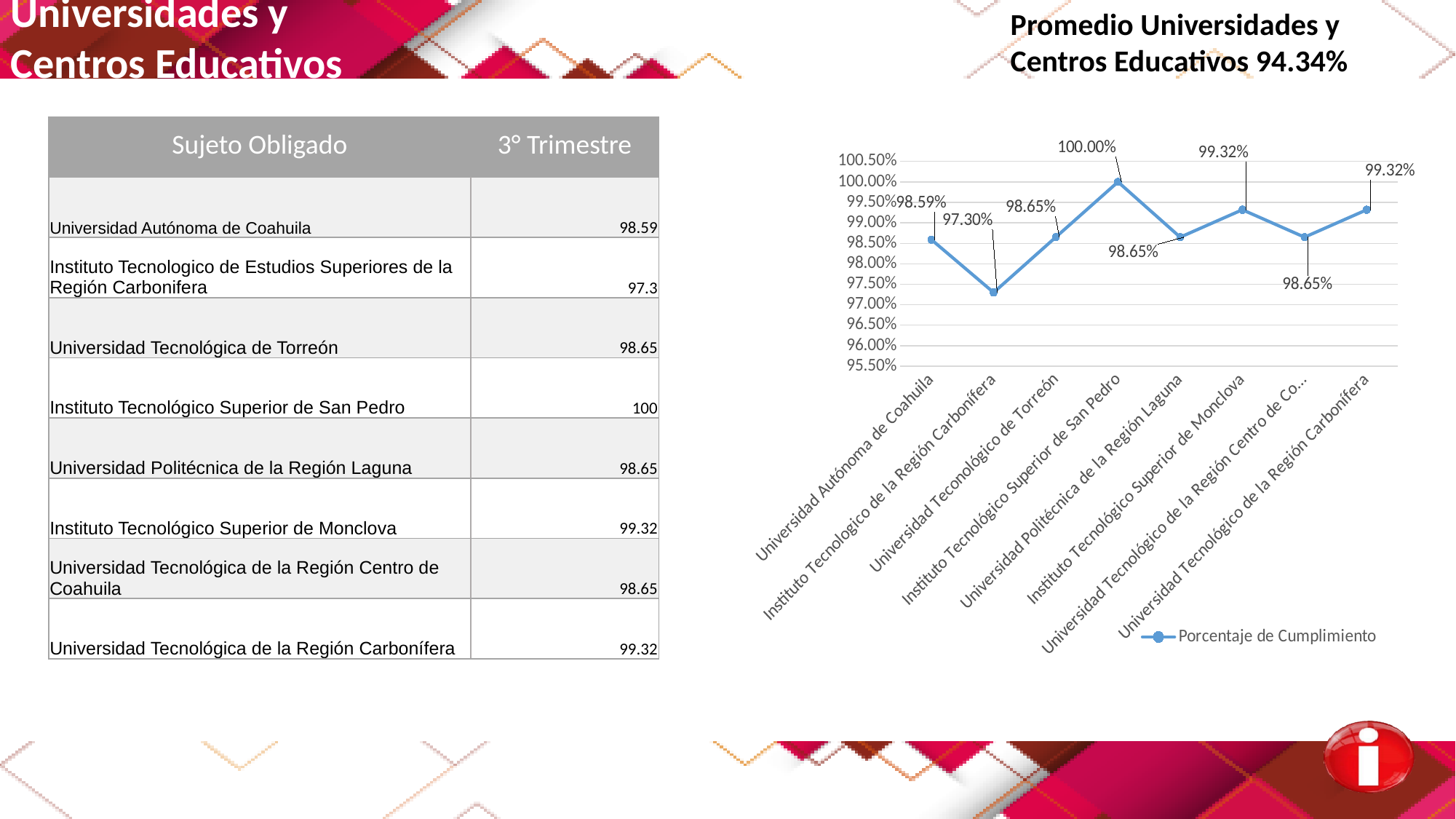
What is the value plotted for Instituto Tecnológico Superior de San Pedro? 100.00% What kind of chart is shown on the slide? line chart How many data points are plotted in the chart? 8 Which category has the lowest value in the chart? Instituto Tecnologico de la Región Carbonífera What is the value plotted for Universidad Politécnica de la Región Laguna? 98.65% What is the value plotted for Instituto Tecnológico Superior de Monclova? 99.32% What is the difference between the value for Instituto Tecnológico Superior de San Pedro and the value for Instituto Tecnologico de la Región Carbonífera? 2.70% Which category has the highest value in the chart? Instituto Tecnológico Superior de San Pedro What is the value plotted for Universidad Autónoma de Coahuila? 98.59% How many series does the chart legend list? 1 What is the name of the series shown in the chart legend? Porcentaje de Cumplimiento Which is larger: the value for Universidad Autónoma de Coahuila or the value for Universidad Tecnológica de Torreón? Universidad Tecnológica de Torreón